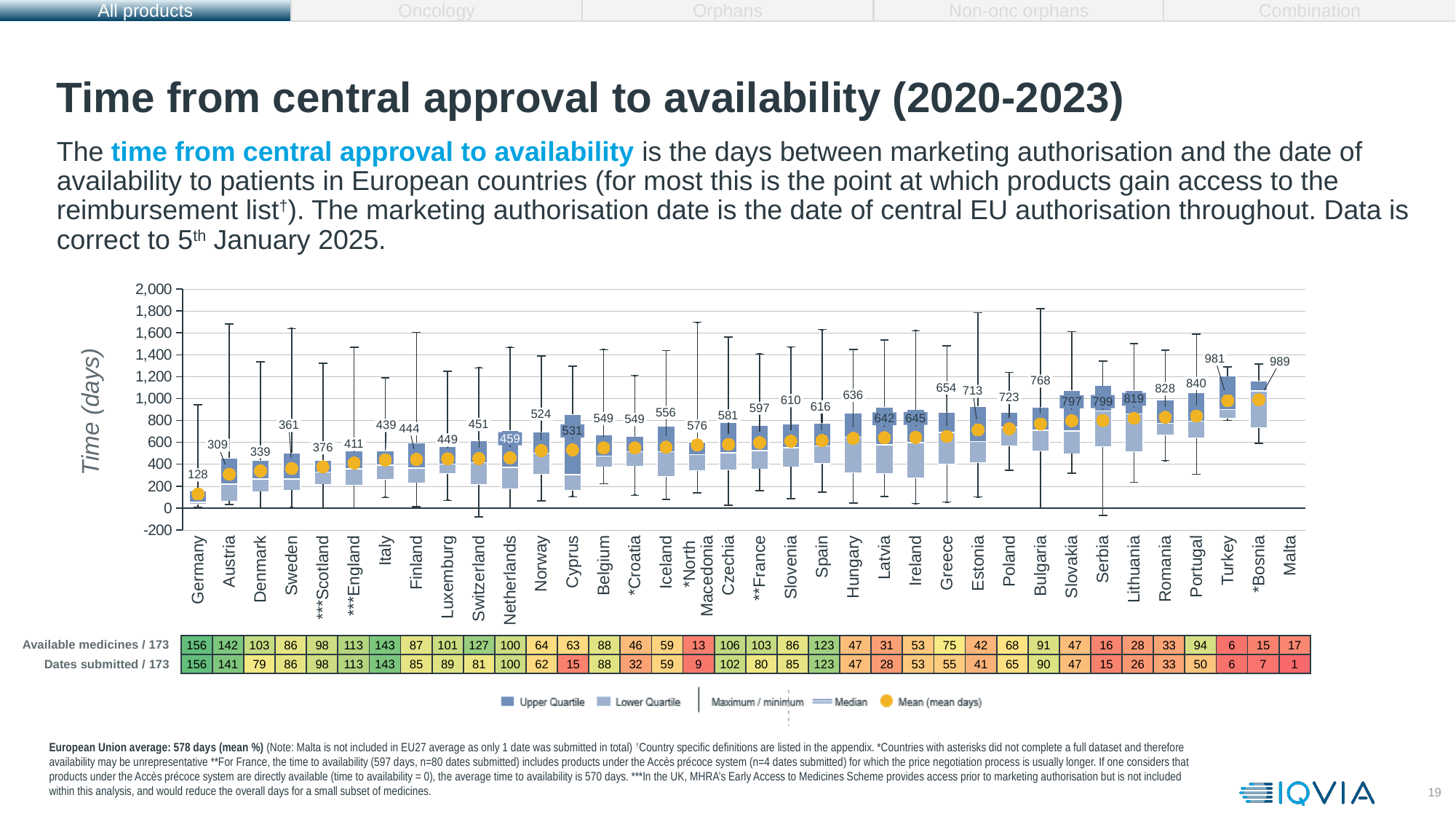
Do the labelled mean values generally rise or fall moving from left to right along the x axis? Rise What mean value is labelled for Bosnia? 989 Is the labelled mean value for Turkey greater or less than 800? greater Which country has the highest labelled mean time from central approval to availability? Bosnia What is the difference between the labelled mean values for Bosnia and Germany? 861 What is the mean value labelled for France in the chart? 597 What kind of chart is used to show the time from central approval to availability? Box plot What is the label on the y axis of the chart? Time (days) How many countries are listed along the x axis of the chart? 36 Which has a higher labelled mean value, Poland or Estonia? Poland Which country has the lowest labelled mean time from central approval to availability? Germany What is the mean time from central approval to availability (in days) shown for Germany? 128